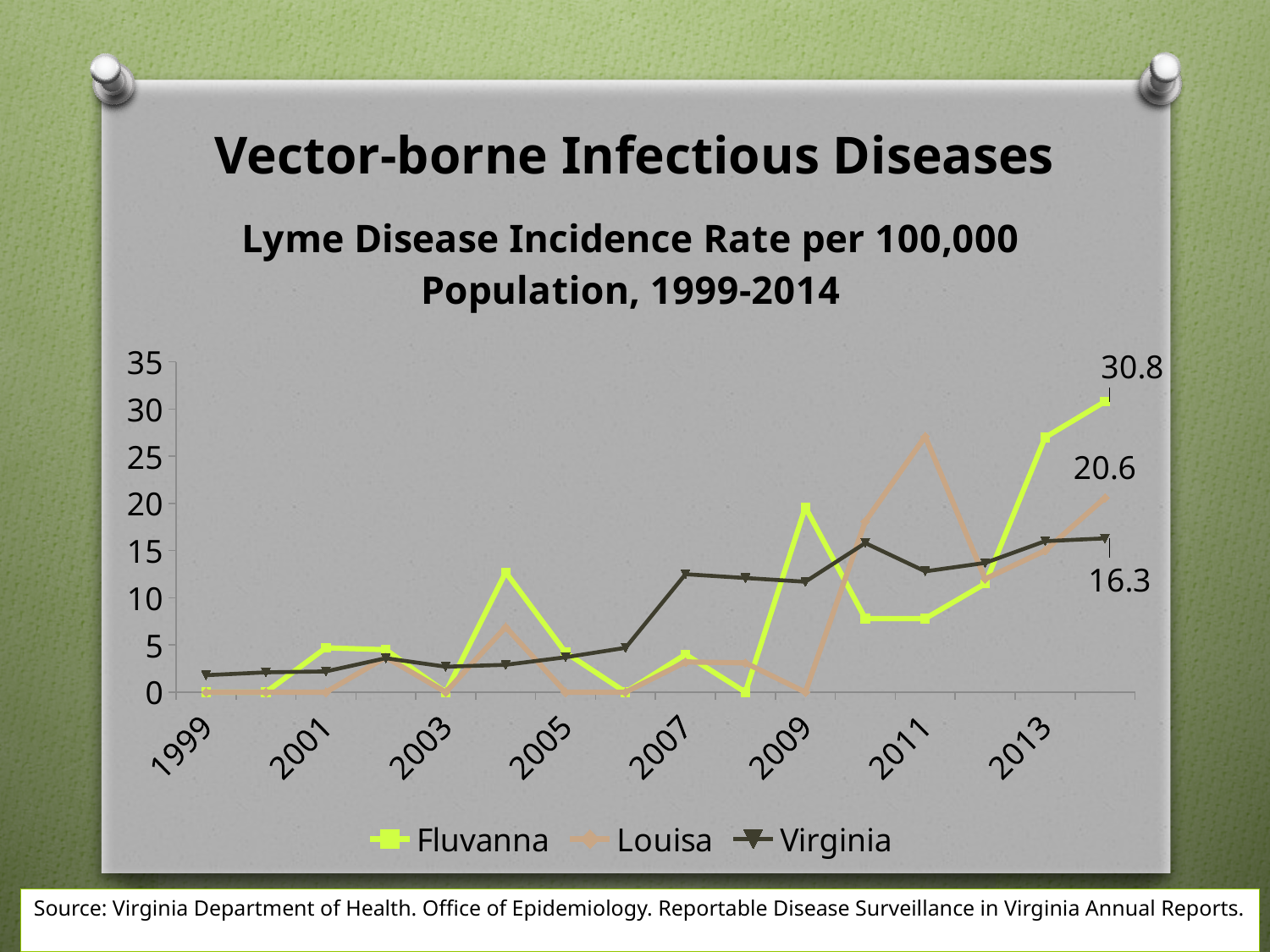
How many series does the legend list? 3 What is the Lyme disease incidence rate for Virginia in 2014? 16.3 What is the difference between Louisa's and Virginia's 2014 rates? 4.3 What kind of chart is shown on the slide? line chart Is the value for Louisa in 2011 greater or less than 25? greater How much higher is Fluvanna's 2014 rate than Louisa's 2014 rate? 10.2 Is the value for Fluvanna in 2009 greater or less than 15? greater Which series has the lowest value in 2014? Virginia What is the Lyme disease incidence rate for Louisa in 2014? 20.6 Which series has the highest value in 2014? Fluvanna What is the Lyme disease incidence rate for Fluvanna in 2014? 30.8 What is the title of the chart? Lyme Disease Incidence Rate per 100,000 Population, 1999-2014